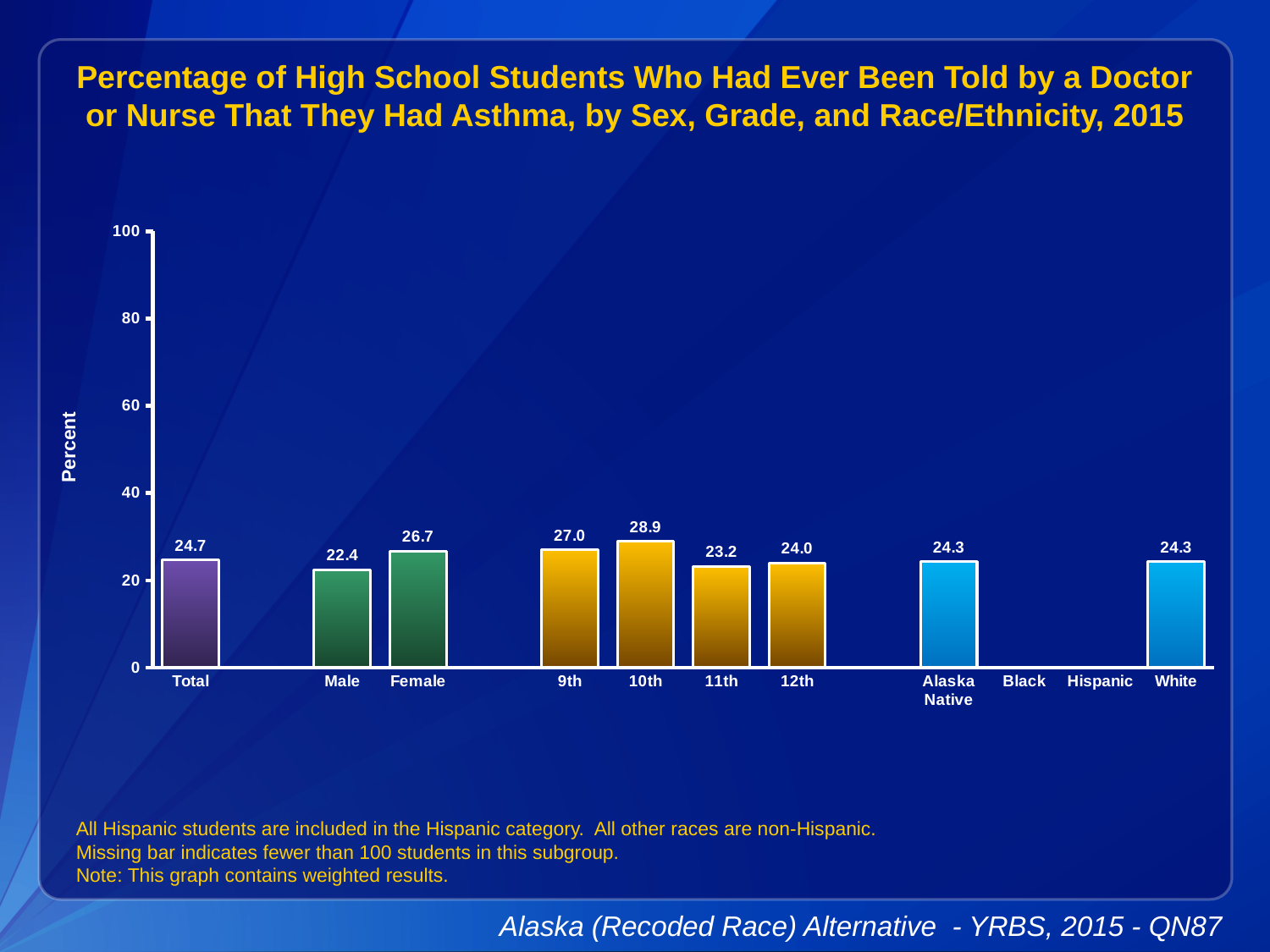
What is the value for 10th grade? 28.9 What is the label on the y axis? Percent What kind of chart is shown on the slide? bar chart What is the value for Total? 24.7 Is the value for 12th grade greater or less than 40? less How many categories on the x axis have no bar shown? 2 What is the difference between the Female and Male values? 4.3 What is the value for Female? 26.7 Which is larger, the value for 9th grade or the value for 11th grade? 9th Which category with a bar has the lowest value? Male What is the value for Alaska Native? 24.3 Which category has the highest value? 10th